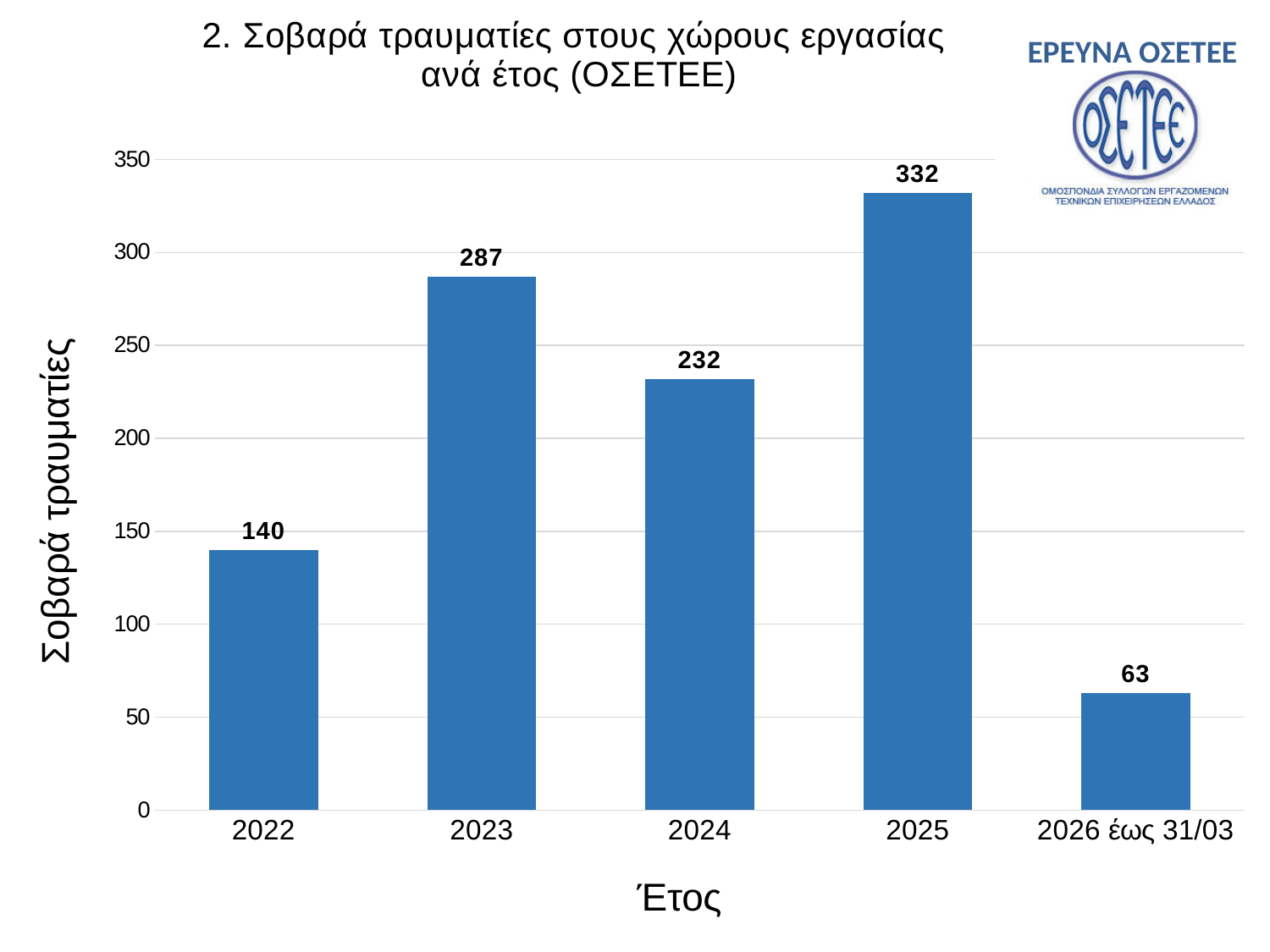
Which year has the highest number of serious injuries? 2025 What is the value for 2023? 287 How many categories are shown on the x axis? 5 Which category has the lowest value? 2026 έως 31/03 Is the value for 2024 greater or less than 200? greater What kind of chart is this? bar chart What is the label of the x axis? Έτος What is the value for 2025? 332 What is the difference between the values for 2023 and 2022? 147 Which is larger, the value for 2023 or the value for 2024? 2023 What is the difference between the values for 2025 and 2024? 100 What is the value for 2026 έως 31/03? 63